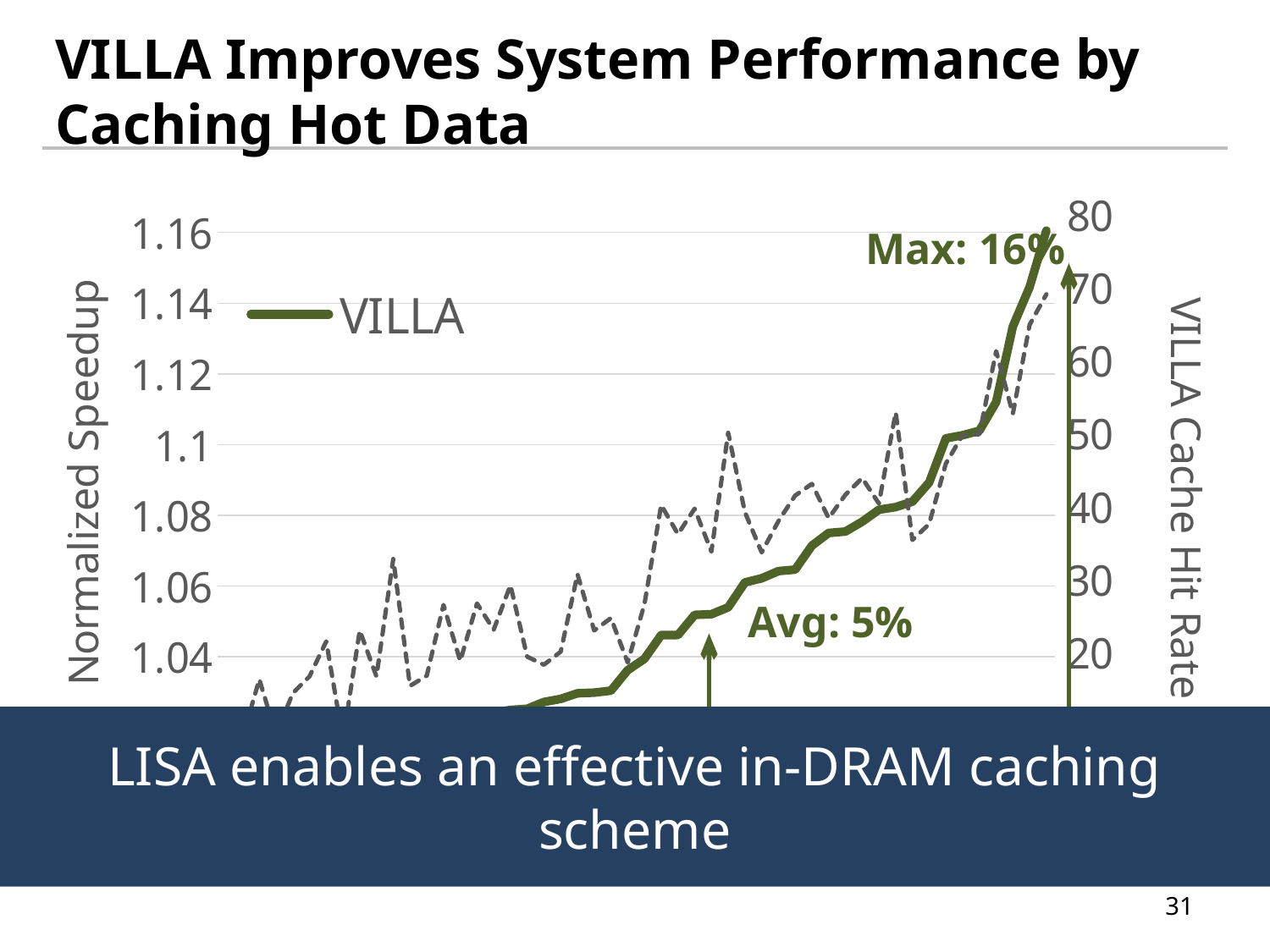
What kind of chart is shown on the slide? line chart Is the VILLA normalized speedup at the rightmost point greater or less than 1.14? greater Does the VILLA normalized speedup line rise or fall from left to right along the x axis? rise Is the VILLA normalized speedup at the point where the Avg: 5% arrow points greater or less than 1.08? less What maximum speedup is annotated on the chart? 16% What is the highest tick value shown on the right VILLA Cache Hit Rate axis? 80 What average speedup is annotated on the chart? 5% Which series does the chart's legend list? VILLA What is the label of the left vertical axis? Normalized Speedup How many series does the chart's legend list? 1 What is the highest tick value shown on the left Normalized Speedup axis? 1.16